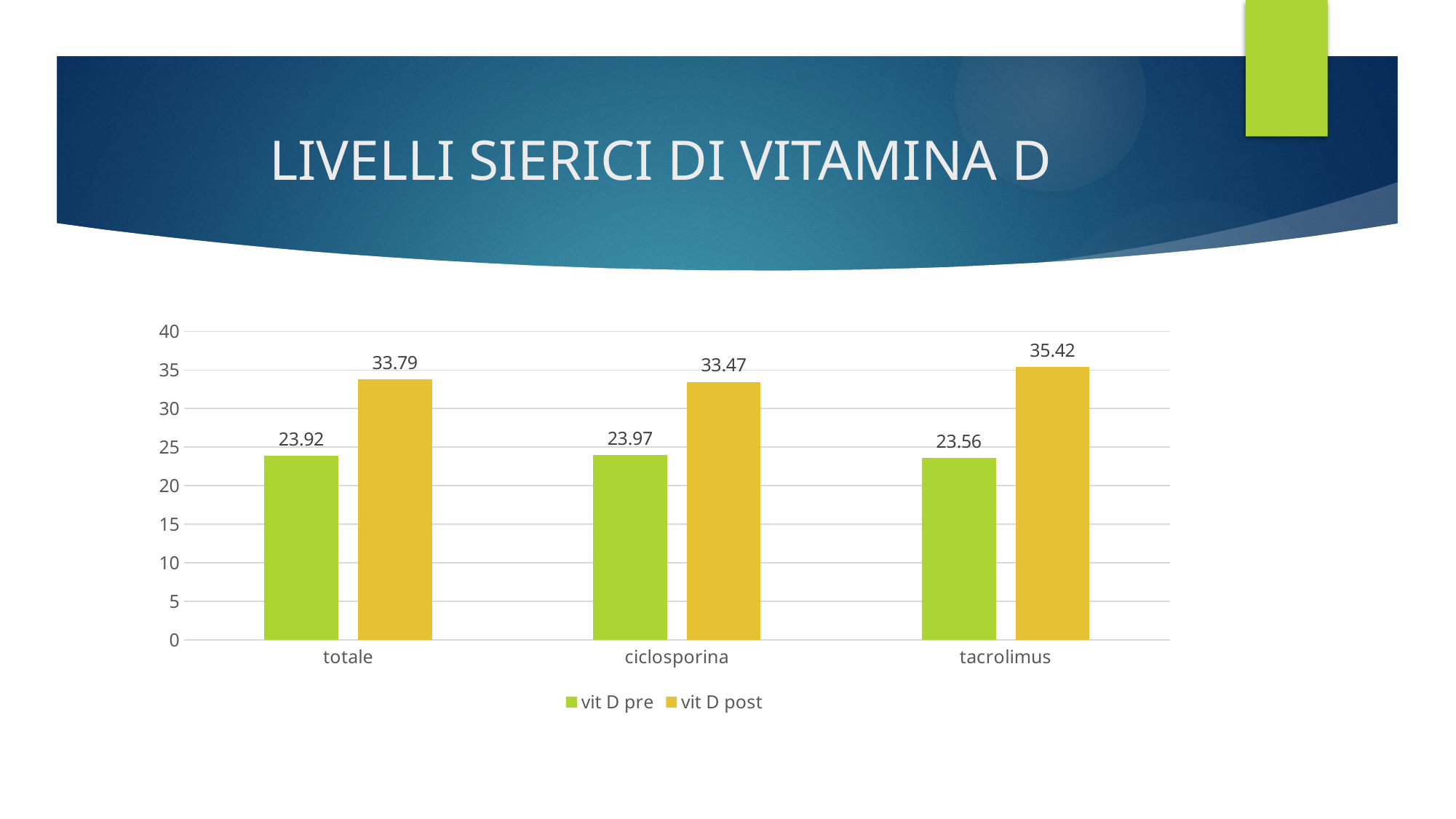
Which category has the highest vit D post value? tacrolimus What is the difference between vit D post and vit D pre for tacrolimus? 11.86 Is the vit D post value for tacrolimus greater or less than 35? greater How many series does the legend list? 2 What is the vit D pre value for totale? 23.92 What is the vit D post value for tacrolimus? 35.42 How many categories are shown on the x axis? 3 What is the difference between vit D post and vit D pre for totale? 9.87 What is the vit D post value for ciclosporina? 33.47 Which category has the lowest vit D pre value? tacrolimus Which is larger for ciclosporina, vit D pre or vit D post? vit D post What kind of chart is shown on the slide? bar chart